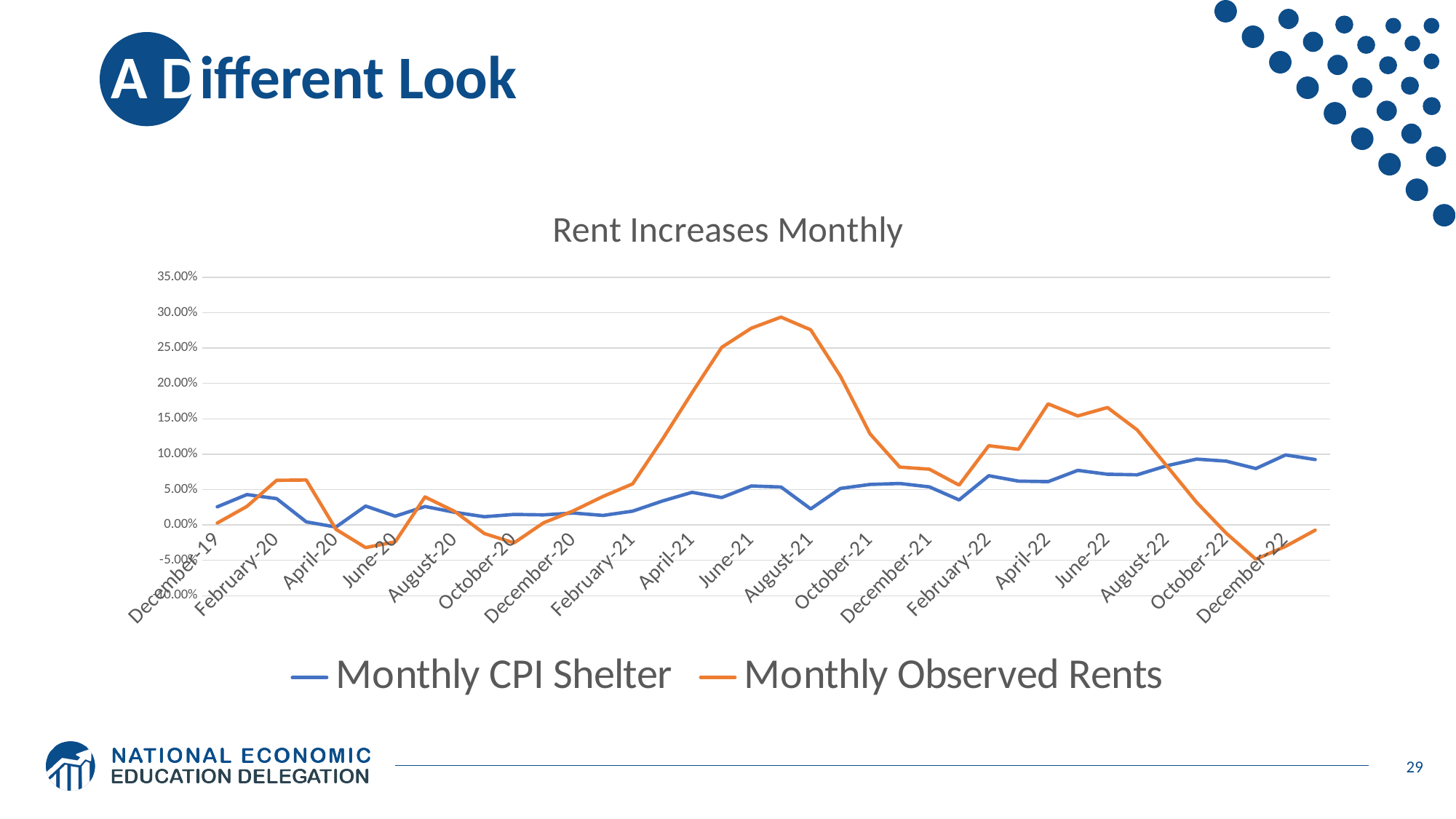
Is the value for Monthly Observed Rents in October-22 greater or less than 5.00%? less Is the value for Monthly CPI Shelter in December-22 greater or less than 5.00%? greater What kind of chart is shown on the slide? line chart Which colour is used for the Monthly Observed Rents line? orange Is the value for Monthly Observed Rents in June-21 greater or less than 25.00%? greater Which series reaches the highest value on the chart? Monthly Observed Rents How many month labels are shown on the x axis? 19 Does the Monthly Observed Rents line rise or fall between August-21 and October-21? fall In June-21, which series has the higher value, Monthly CPI Shelter or Monthly Observed Rents? Monthly Observed Rents In December-22, which series has the higher value, Monthly CPI Shelter or Monthly Observed Rents? Monthly CPI Shelter What is the title of the chart? Rent Increases Monthly How many series does the legend list? 2